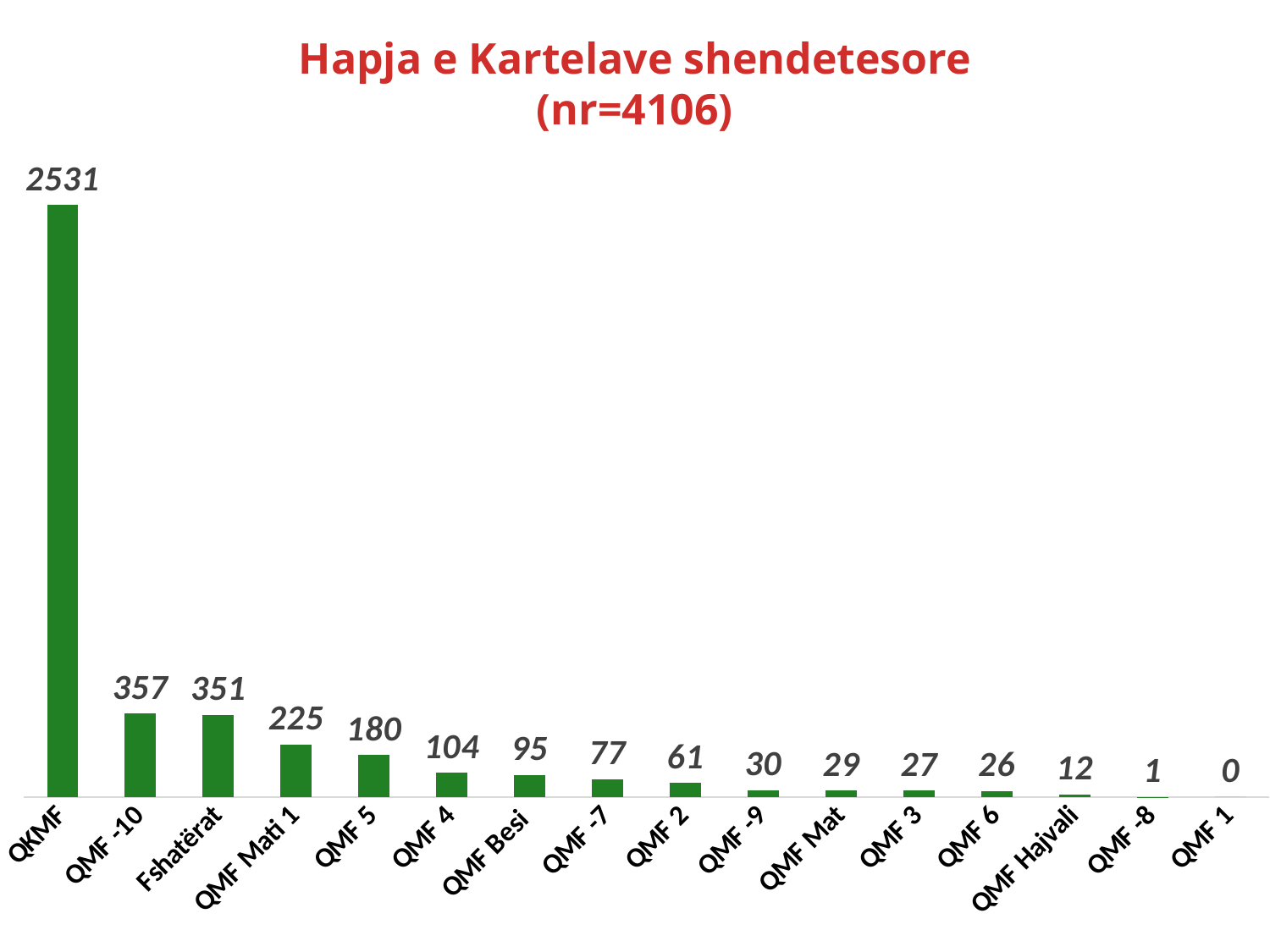
Which is larger, the value for QMF 2 or the value for QMF -9? QMF 2 What is the value for QMF Mati 1? 225 Which category has the highest value? QKMF What is the difference between the values for QMF -10 and QMF 5? 177 What is the value for QMF Besi? 95 What is the difference between the values for QMF 4 and QMF -7? 27 What is the value for QKMF? 2531 What is the value for QMF Hajvali? 12 Which category has the lowest value? QMF 1 How many categories are shown on the x axis? 16 What is the title of the chart? Hapja e Kartelave shendetesore (nr=4106) What type of chart is shown on the slide? bar chart